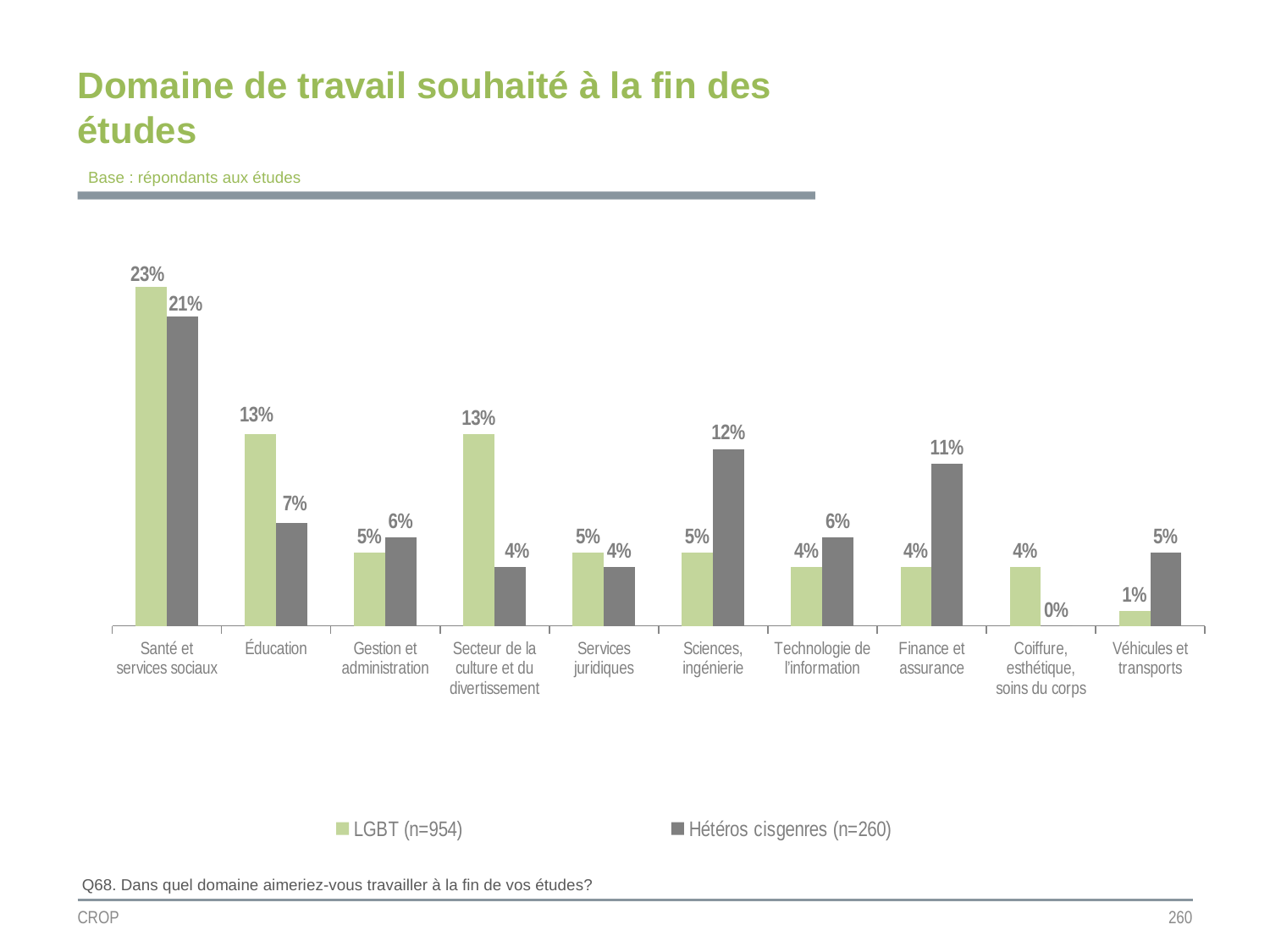
What kind of chart is shown on the slide? Bar chart How many categories are shown on the x axis? 10 How many series does the legend list? 2 Which category has the lowest value for the LGBT (n=954) series? Véhicules et transports What is the title of the chart on the slide? Domaine de travail souhaité à la fin des études Which category has the highest value for the LGBT (n=954) series? Santé et services sociaux What is the value for LGBT (n=954) in the Santé et services sociaux category? 23% Which series has the larger value in the Finance et assurance category? Hétéros cisgenres (n=260) What is the value for Hétéros cisgenres (n=260) in the Sciences, ingénierie category? 12% What is the difference between the LGBT (n=954) and Hétéros cisgenres (n=260) values for Secteur de la culture et du divertissement? 9 percentage points What is the value for Hétéros cisgenres (n=260) in the Coiffure, esthétique, soins du corps category? 0% Which series has the larger value in the Éducation category? LGBT (n=954)